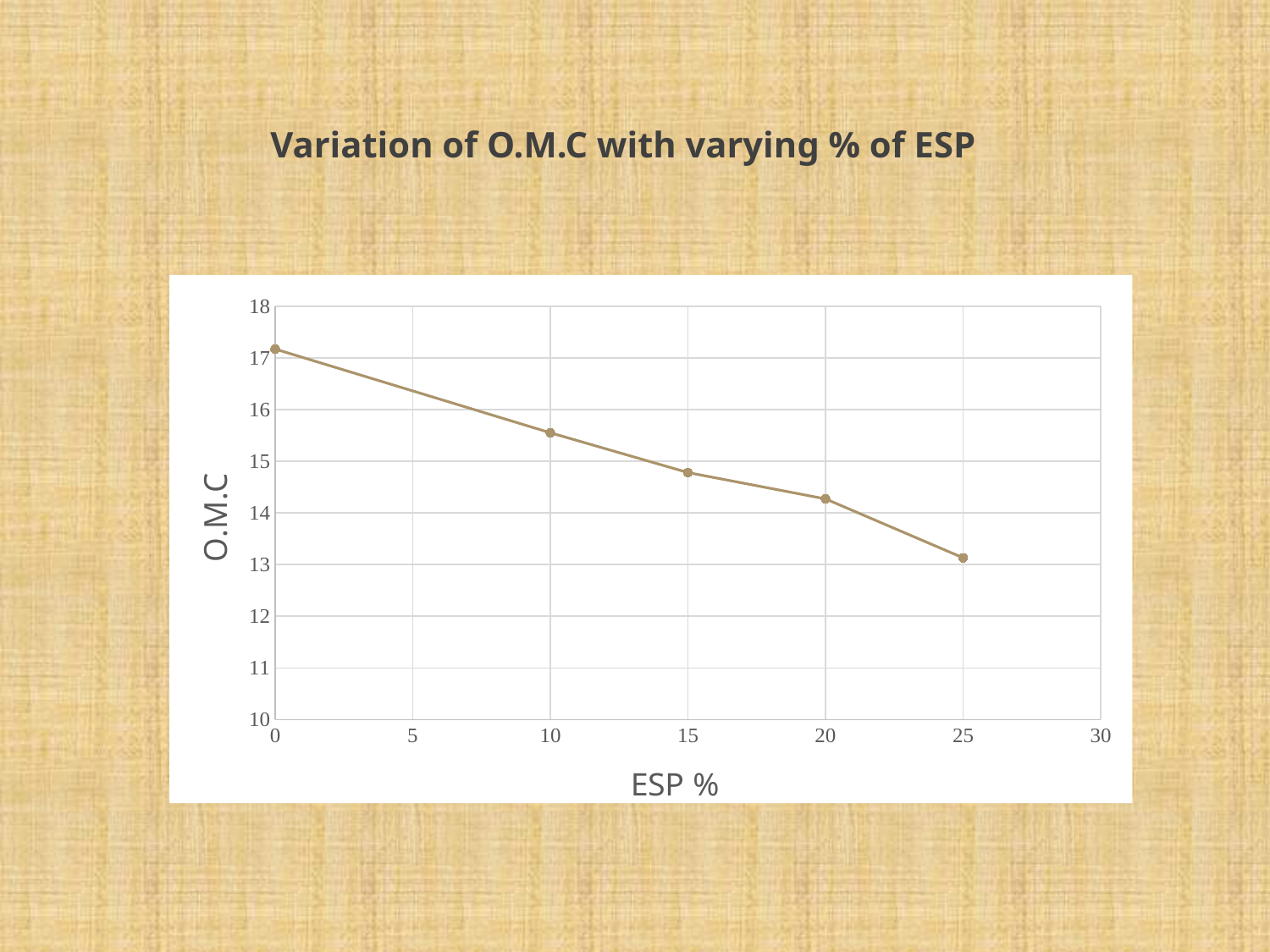
Is the O.M.C value at ESP 0% greater or less than 16? greater Is the O.M.C value at ESP 10% greater or less than 15? greater What kind of chart is shown on the slide? line chart At which ESP % is the O.M.C value highest? 0 How many data points are plotted on the chart? 5 Is the O.M.C value at ESP 25% greater or less than 14? less Which has the larger O.M.C value: ESP 10% or ESP 20%? ESP 10% What is the title of the chart? Variation of O.M.C with varying % of ESP Do the O.M.C values rise or fall as ESP % increases along the x axis? fall At which ESP % is the O.M.C value lowest? 25 What is the label of the x axis? ESP %